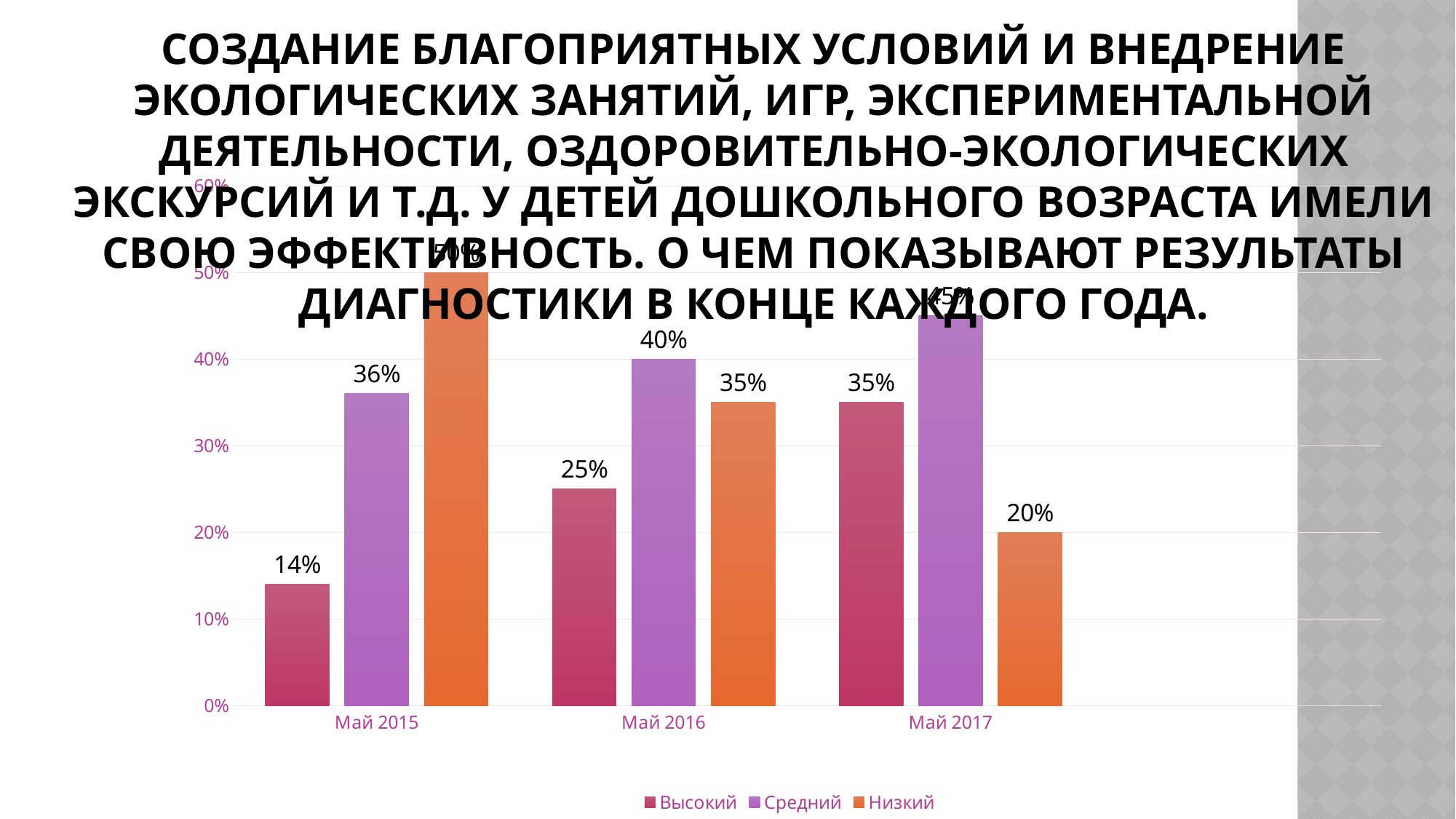
How many series does the legend list? 3 Which category has the lowest value for Низкий? Май 2017 What is the value for Низкий in Май 2017? 20% What is the value for Высокий in Май 2015? 14% How many categories are shown on the x axis? 3 Is the value for Средний in Май 2017 greater or less than 40%? greater What type of chart is shown on the slide? bar chart What is the difference between the Средний value in Май 2016 and the Средний value in Май 2015? 4% Which category has the highest value for Высокий? Май 2017 What is the value for Средний in Май 2016? 40% Does the value for Высокий rise or fall from Май 2015 to Май 2017? rise What is the value for Высокий in Май 2017? 35%